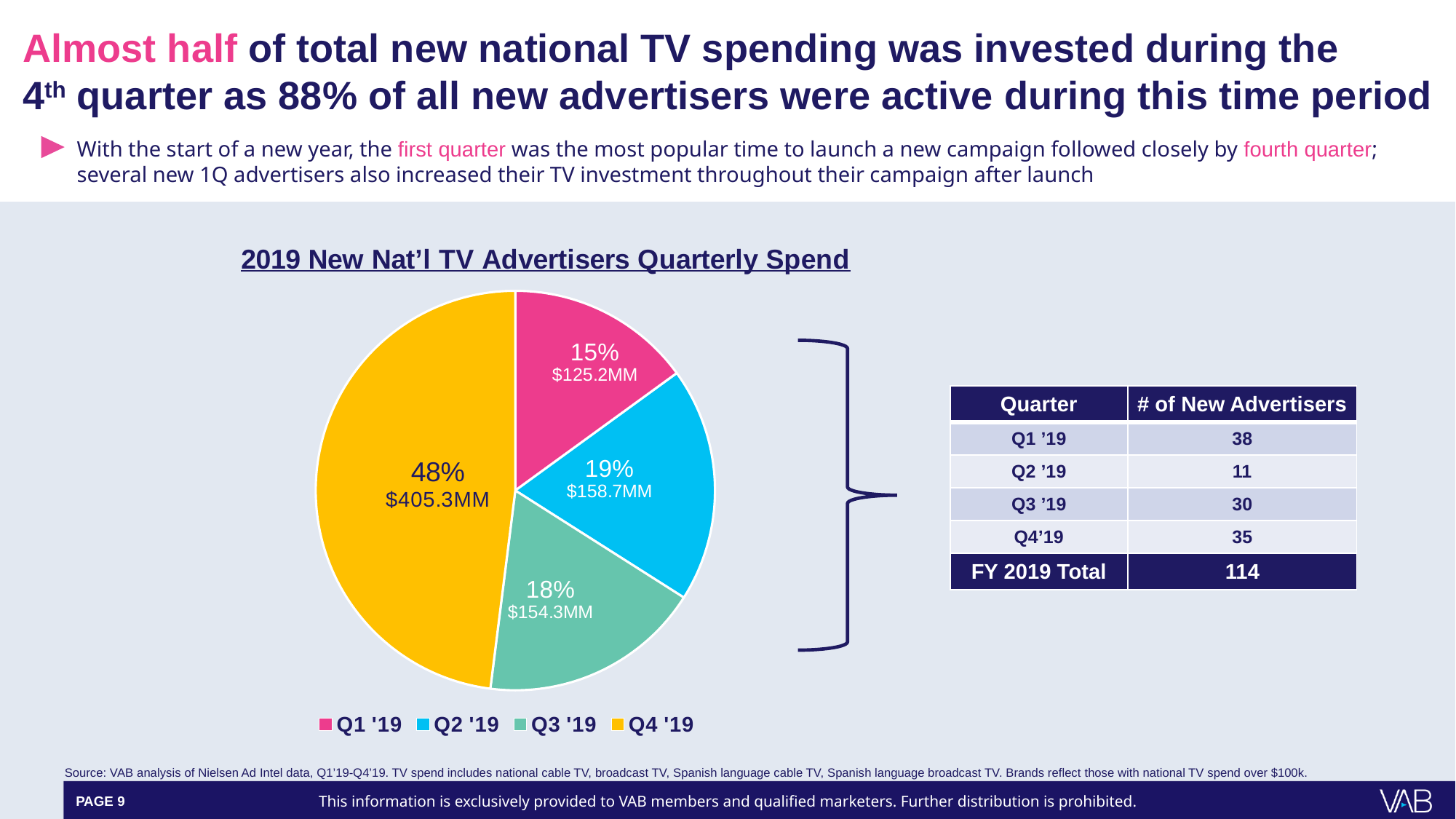
What type of chart is used to show the 2019 New Nat'l TV Advertisers Quarterly Spend? Pie chart What is the spend value shown for Q4 '19 in the pie chart? $405.3MM How many slices does the pie chart have? 4 Which quarter has the smallest slice in the pie chart? Q1 '19 What is the spend value shown for Q1 '19 in the pie chart? $125.2MM Which quarter has the largest slice in the pie chart? Q4 '19 What share of the pie does Q4 '19 represent? 48% What is the spend value shown for Q3 '19 in the pie chart? $154.3MM What is the title of the pie chart? 2019 New Nat'l TV Advertisers Quarterly Spend What share of the pie does Q2 '19 represent? 19% What is the spend value shown for Q2 '19 in the pie chart? $158.7MM What is the difference in spend between Q4 '19 and Q1 '19 in the pie chart? $280.1MM